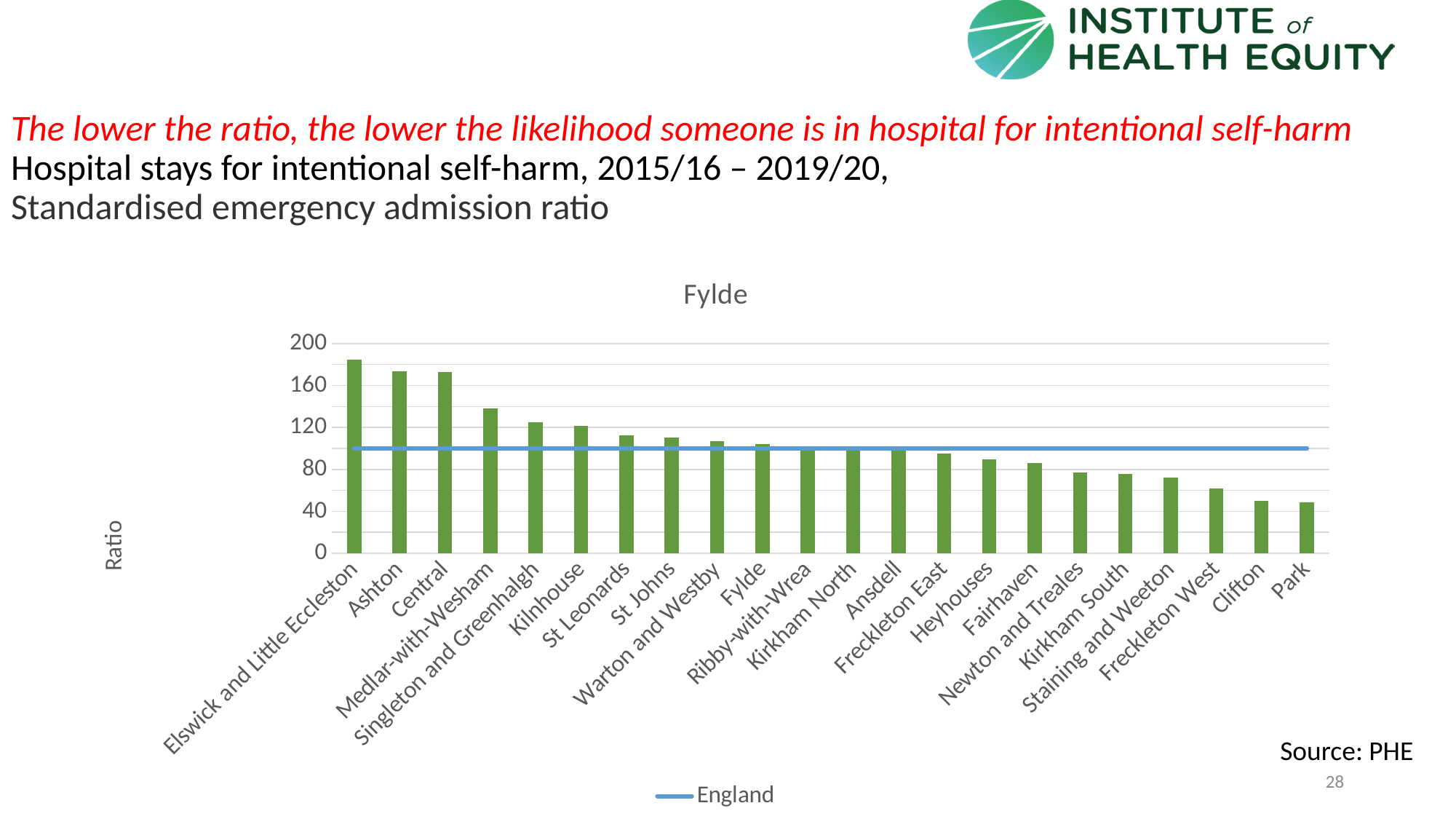
Do the bar values rise or fall moving from left to right along the x axis? Fall Is the value for Park greater or less than 80? less Which has the larger value, Medlar-with-Wesham or Singleton and Greenhalgh? Medlar-with-Wesham Is the value for St Leonards greater or less than 120? less Is the value for Freckleton West greater or less than 80? less What kind of chart is shown on the slide? Combination bar and line chart What is the title of the chart? Fylde How many bars (areas) are plotted in the chart? 22 How many series does the legend list? 1 Which area has the highest ratio in the chart? Elswick and Little Eccleston